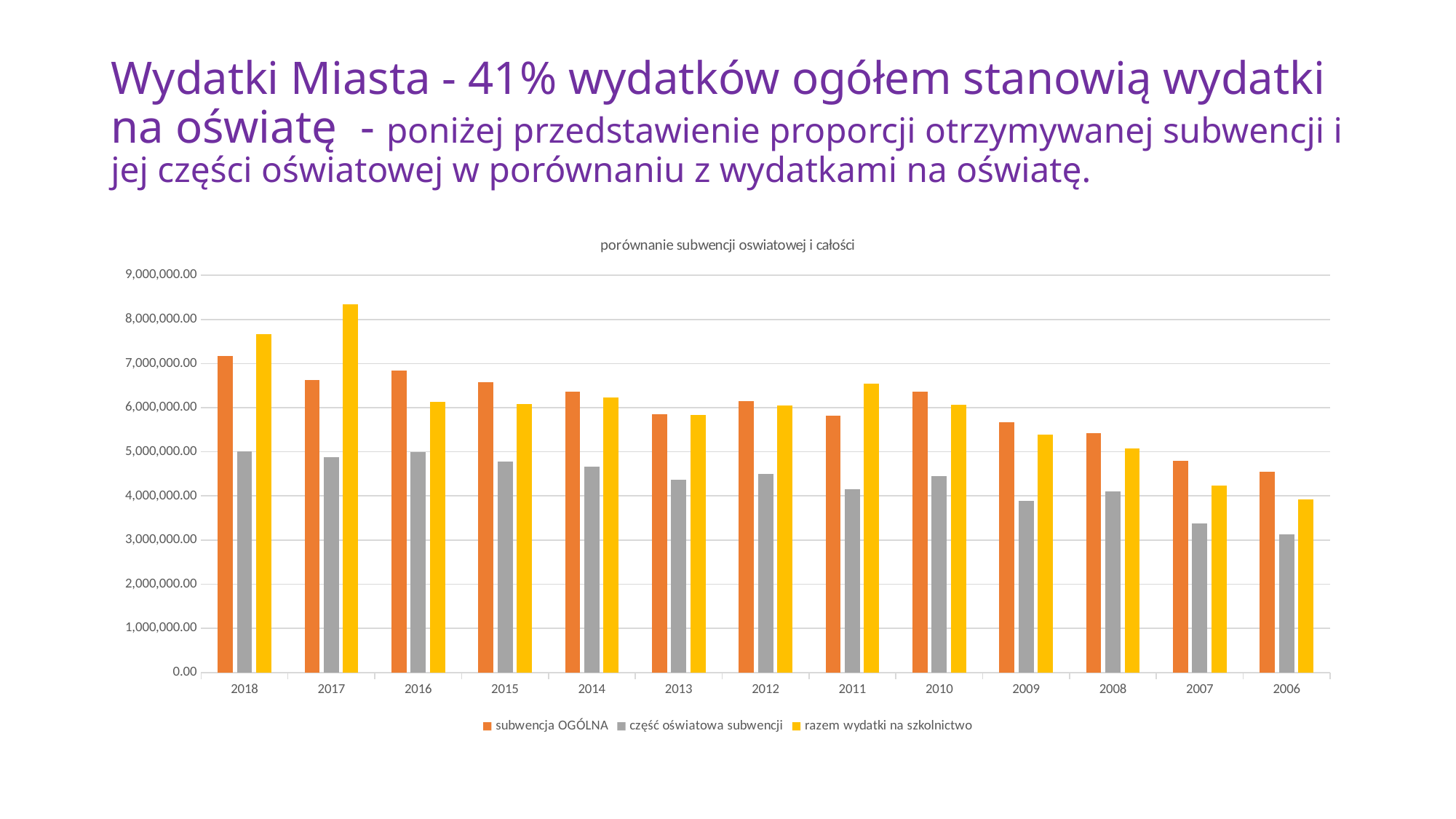
Is the value for 'część oświatowa subwencji' in 2006 greater or less than 4,000,000.00? less Is the value for 'razem wydatki na szkolnictwo' in 2017 greater or less than 8,000,000.00? greater Which year has the highest value for 'razem wydatki na szkolnictwo'? 2017 What kind of chart is shown on the slide? bar chart Do the values for 'część oświatowa subwencji' generally rise or fall moving from 2018 to 2006 along the x axis? fall What is the title of the chart? porównanie subwencji oswiatowej i całości How many series does the legend list? 3 Is the value for 'razem wydatki na szkolnictwo' in 2011 greater or less than 6,000,000.00? greater In 2016, which is larger: 'subwencja OGÓLNA' or 'razem wydatki na szkolnictwo'? subwencja OGÓLNA Which year has the highest value for 'subwencja OGÓLNA'? 2018 How many years are shown on the x axis? 13 Which year has the lowest value for 'część oświatowa subwencji'? 2006